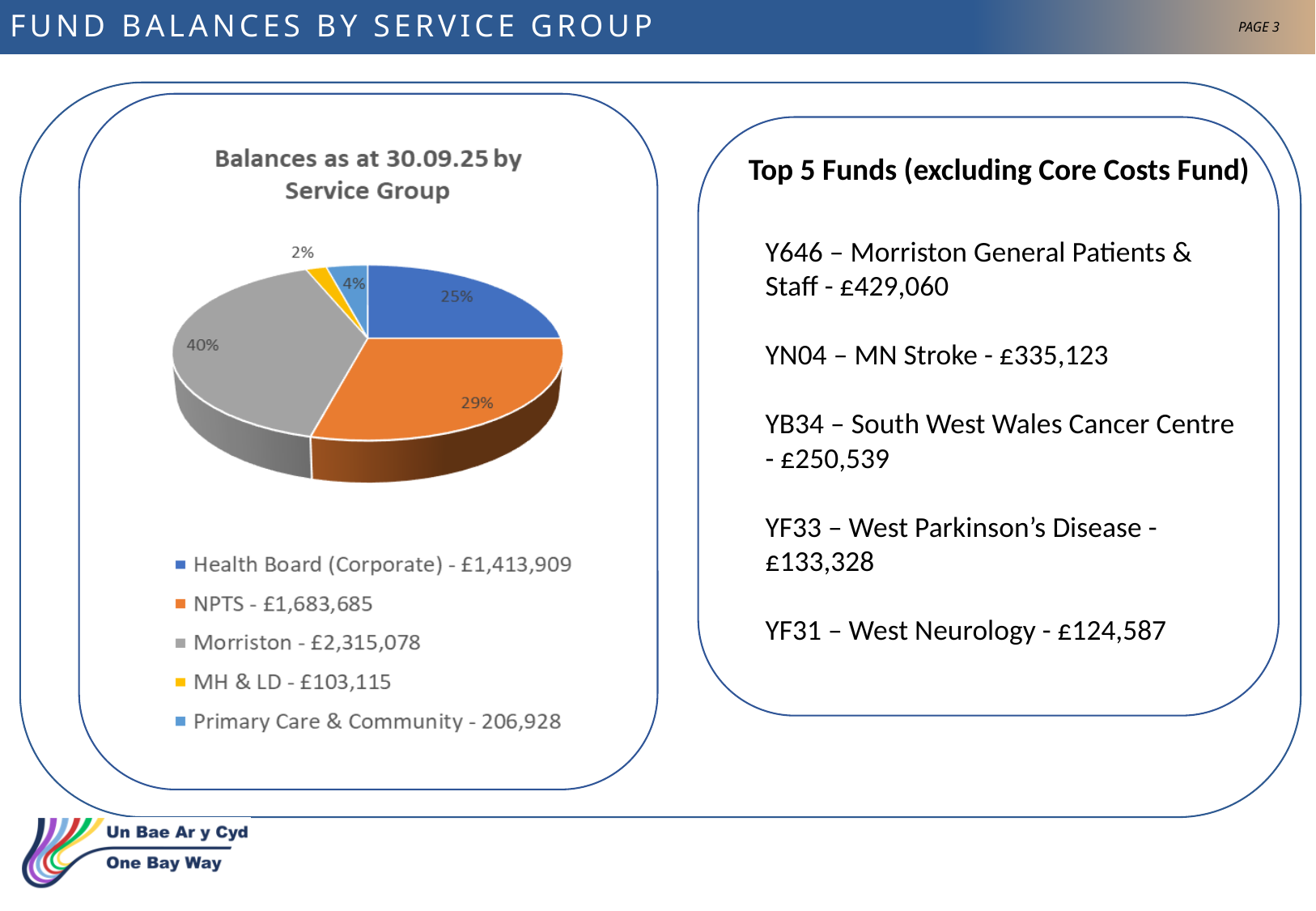
Which has the larger share of the pie, NPTS or Health Board (Corporate)? NPTS What share of the pie does Morriston represent? 40% How many service groups does the legend list? 5 What share of the pie does NPTS represent? 29% What share of the pie does Health Board (Corporate) represent? 25% What balance is shown in the legend for Morriston? £2,315,078 What balance is shown in the legend for NPTS? £1,683,685 What is the title of the chart? Balances as at 30.09.25 by Service Group What kind of chart is shown on the slide? pie chart Which service group has the smallest share of the pie? MH & LD Which service group has the largest share of the pie? Morriston